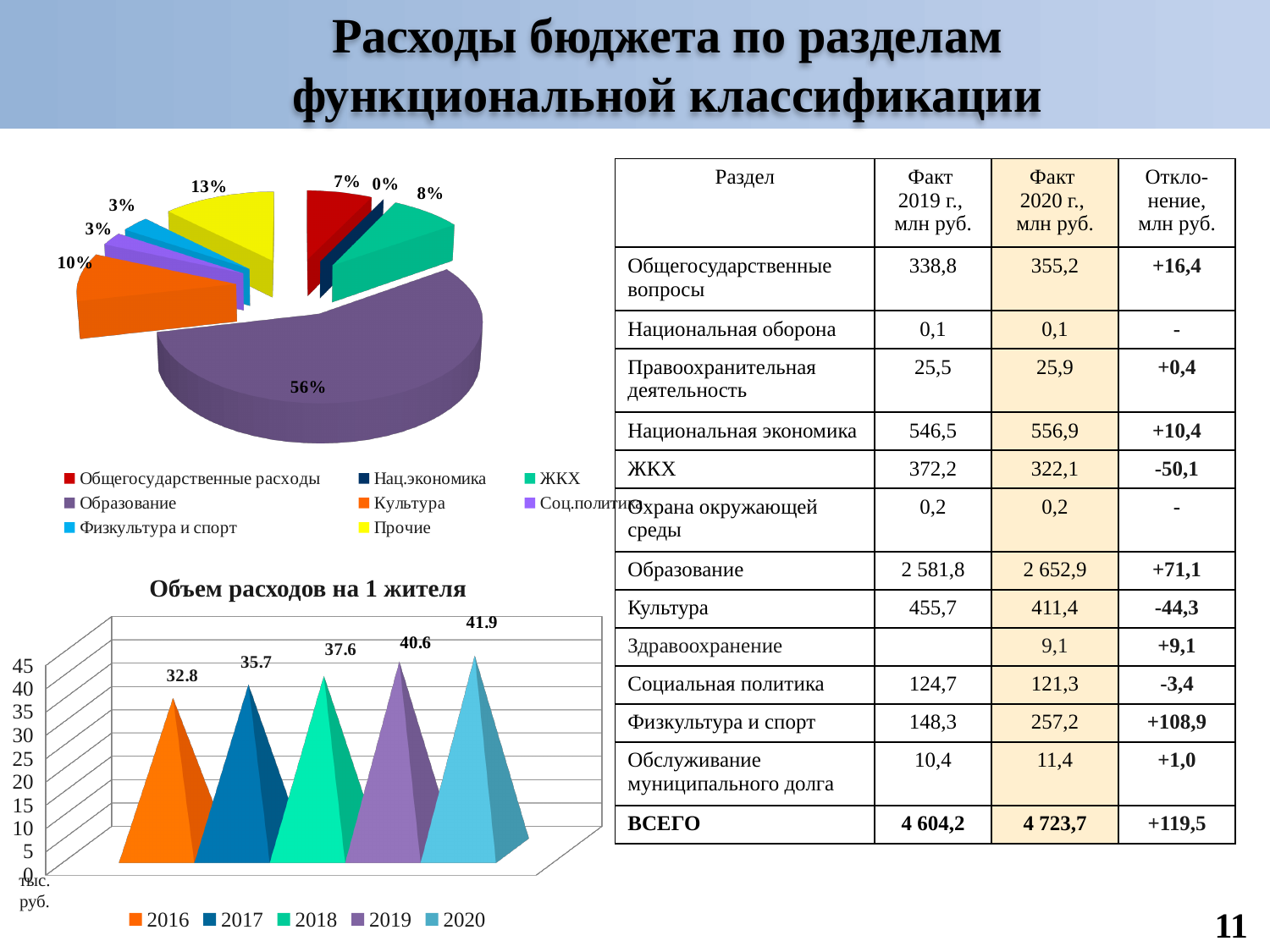
In the chart 'Объем расходов на 1 жителя', what is the value for 2020? 41.9 In the chart 'Объем расходов на 1 жителя', what is the value for 2016? 32.8 How many years does the legend of the chart 'Объем расходов на 1 жителя' list? 5 In the chart 'Объем расходов на 1 жителя', which is larger, the value for 2019 or the value for 2018? 2019 In the pie chart at the top left, what share does Прочие have? 13% In the pie chart at the top left, which category has the largest slice? Образование In the chart 'Объем расходов на 1 жителя', what is the difference between the values for 2020 and 2016? 9.1 How many entries does the legend of the pie chart at the top left list? 8 In the chart 'Объем расходов на 1 жителя', which year has the lowest value? 2016 In the pie chart at the top left, what share does Образование have? 56% What kind of chart is the chart at the top left of the slide? pie chart In the chart 'Объем расходов на 1 жителя', do the values rise or fall from 2016 to 2020? rise